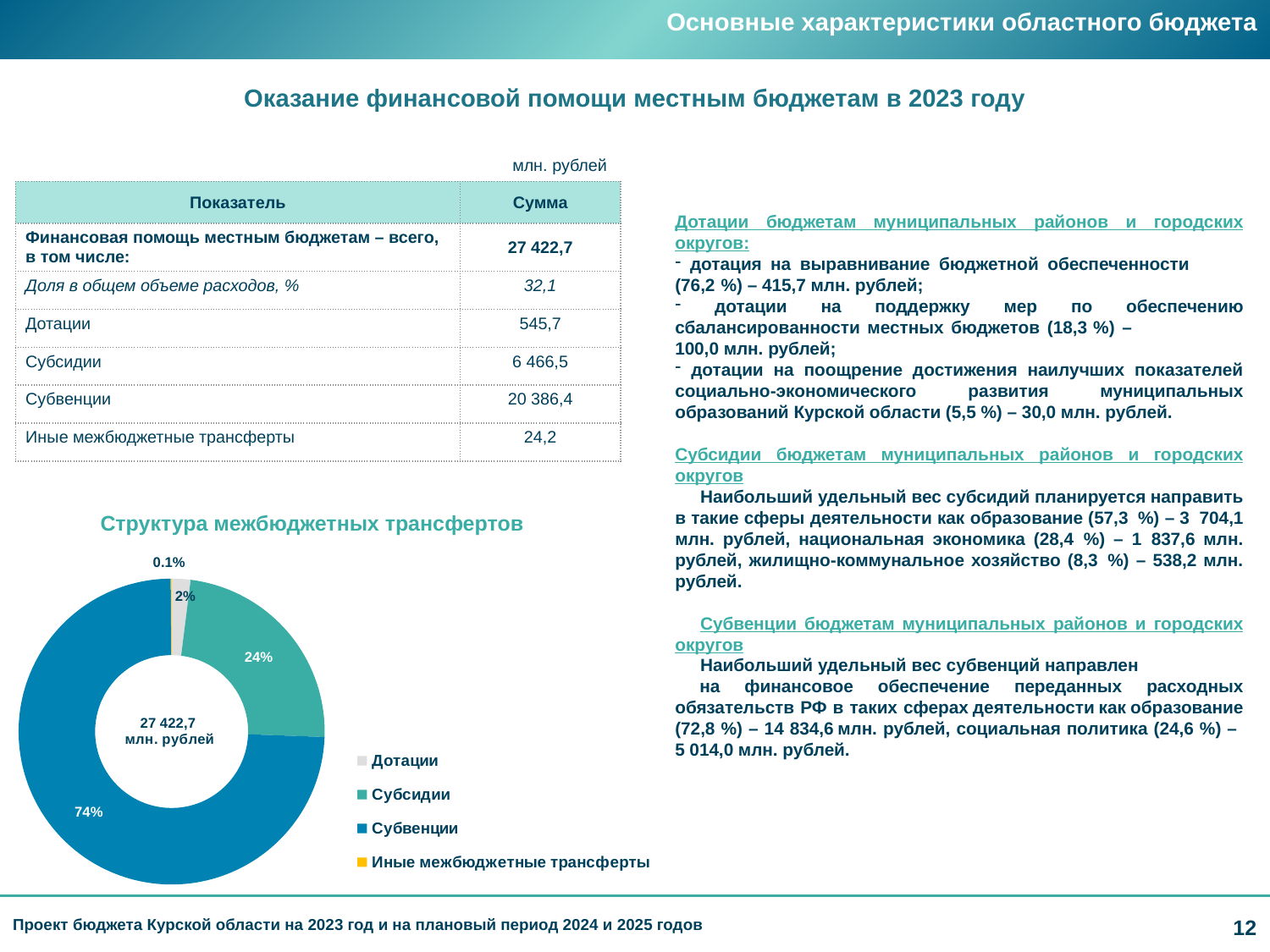
What share of the chart does 'Субвенции' take? 74% What share of the chart does 'Субсидии' take? 24% What kind of chart is shown under the title 'Структура межбюджетных трансфертов'? Doughnut (pie) chart Which category has the largest share in the chart? Субвенции What total value is printed in the centre of the doughnut chart? 27 422,7 млн. рублей Which is larger in the chart: the share of 'Субсидии' or the share of 'Дотации'? Субсидии How many entries does the legend of the chart list? 4 What share of the chart does 'Дотации' take? 2% What is the difference in percentage points between the shares of 'Субвенции' and 'Субсидии' in the chart? 50 Which category has the smallest share in the chart? Иные межбюджетные трансферты What is the title of the chart on the slide? Структура межбюджетных трансфертов